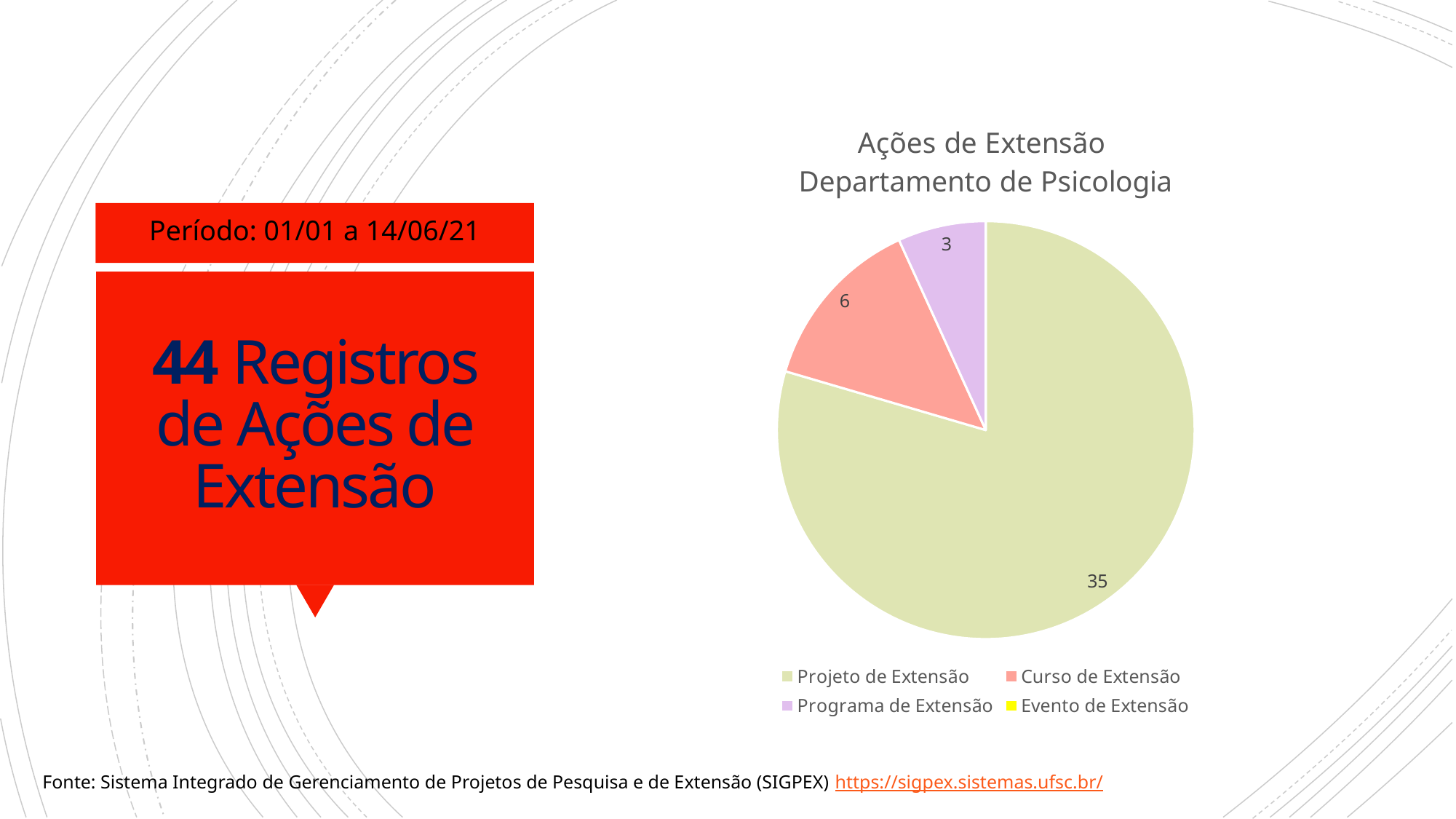
What is the difference between the values for Curso de Extensão and Programa de Extensão? 3 Which category has the largest slice in the pie chart? Projeto de Extensão What is the value for Curso de Extensão in the pie chart? 6 What type of chart is shown on the slide? pie chart What is the difference between the values for Projeto de Extensão and Curso de Extensão? 29 Which is larger, the value for Curso de Extensão or the value for Programa de Extensão? Curso de Extensão What is the title of the chart? Ações de Extensão Departamento de Psicologia What is the value for Programa de Extensão in the pie chart? 3 How many categories does the chart legend list? 4 What is the total of the three values printed on the pie chart? 44 Among the slices with printed values, which category has the smallest value? Programa de Extensão What is the value for Projeto de Extensão in the pie chart? 35